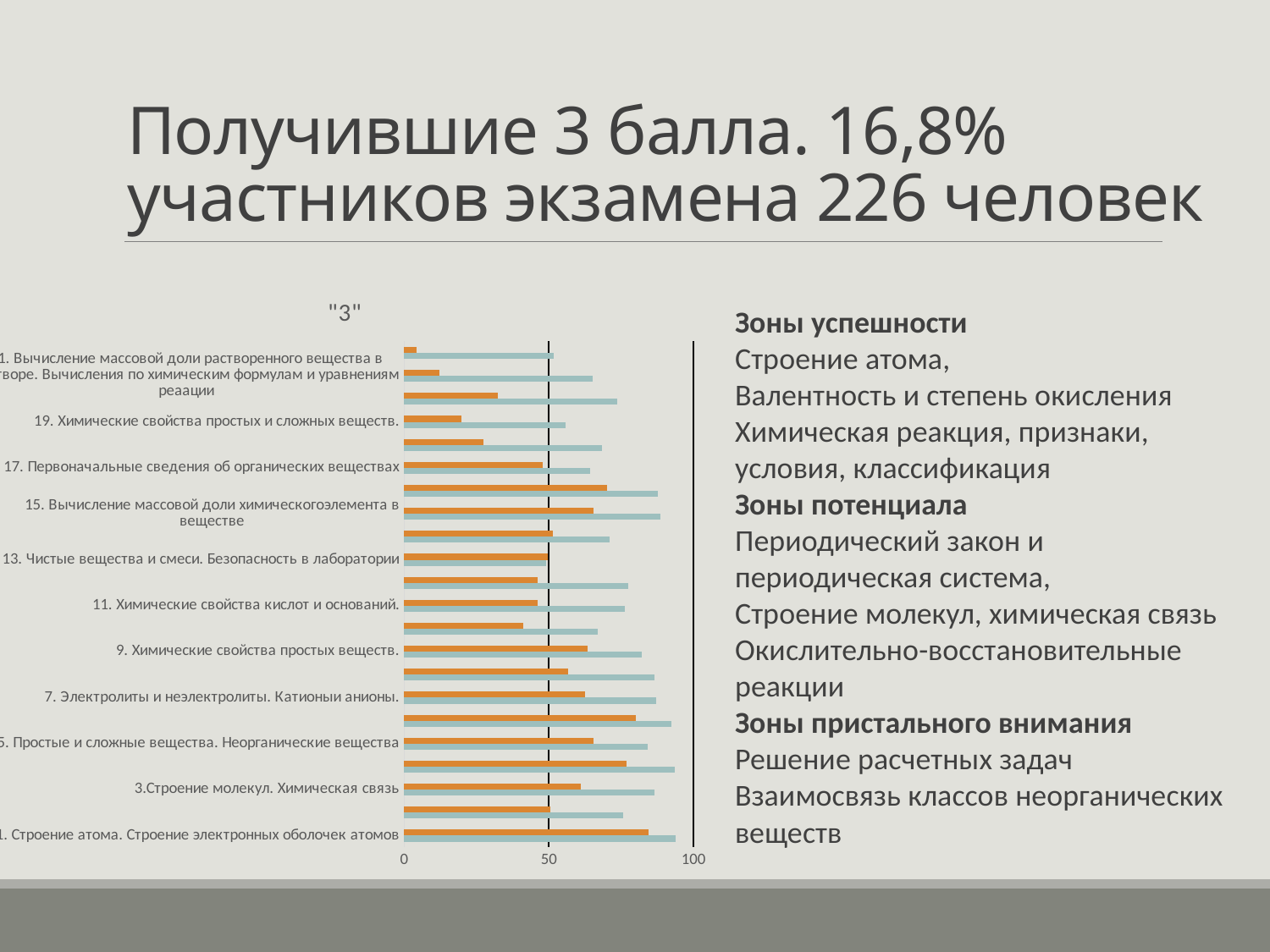
Is the orange bar for "21. Вычисление массовой доли растворенного вещества в растворе..." greater or less than 50? less Is the orange bar for "3.Строение молекул. Химическая связь" greater or less than 50? greater How many data series are plotted in the chart? 2 Is the blue bar for "15. Вычисление массовой доли химического элемента в веществе" greater or less than 50? greater For "1. Строение атома. Строение электронных оболочек атомов", which bar is longer, the orange one or the blue one? the blue one What is the title of the chart? "3" What kind of chart is shown on the slide? bar chart How many categories does the chart have? 22